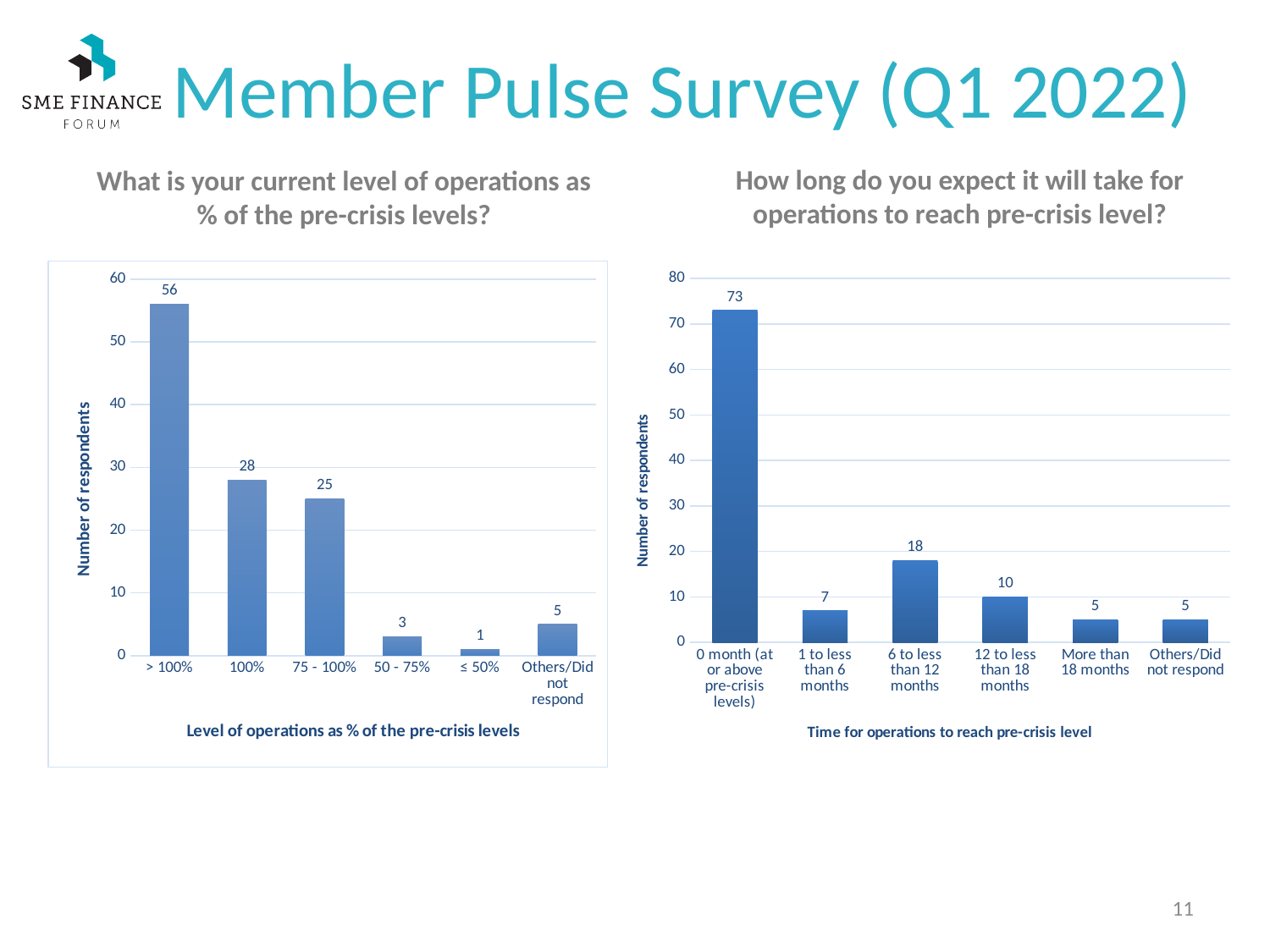
In the right chart (time for operations to reach pre-crisis level), what is the difference between the '0 month' category and the '6 to less than 12 months' category? 55 In the left chart (current level of operations as % of pre-crisis levels), how many respondents reported operations at 50 - 75%? 3 In the right chart (time for operations to reach pre-crisis level), which category has the highest number of respondents? 0 month (at or above pre-crisis levels) In the left chart (current level of operations as % of pre-crisis levels), what is the difference in respondents between the 100% and 75 - 100% categories? 3 In the right chart (time for operations to reach pre-crisis level), which is larger: '1 to less than 6 months' or '12 to less than 18 months'? 12 to less than 18 months In the right chart (time for operations to reach pre-crisis level), how many respondents chose '6 to less than 12 months'? 18 In the left chart (current level of operations as % of pre-crisis levels), how many categories are shown on the x axis? 6 In the right chart (time for operations to reach pre-crisis level), how many respondents chose '0 month (at or above pre-crisis levels)'? 73 In the left chart (current level of operations as % of pre-crisis levels), how many respondents reported operations above 100%? 56 What is the y-axis label of the left chart (current level of operations as % of pre-crisis levels)? Number of respondents In the left chart (current level of operations as % of pre-crisis levels), which category has the lowest number of respondents? ≤ 50% What type of chart is used in the right chart (time for operations to reach pre-crisis level)? Bar chart